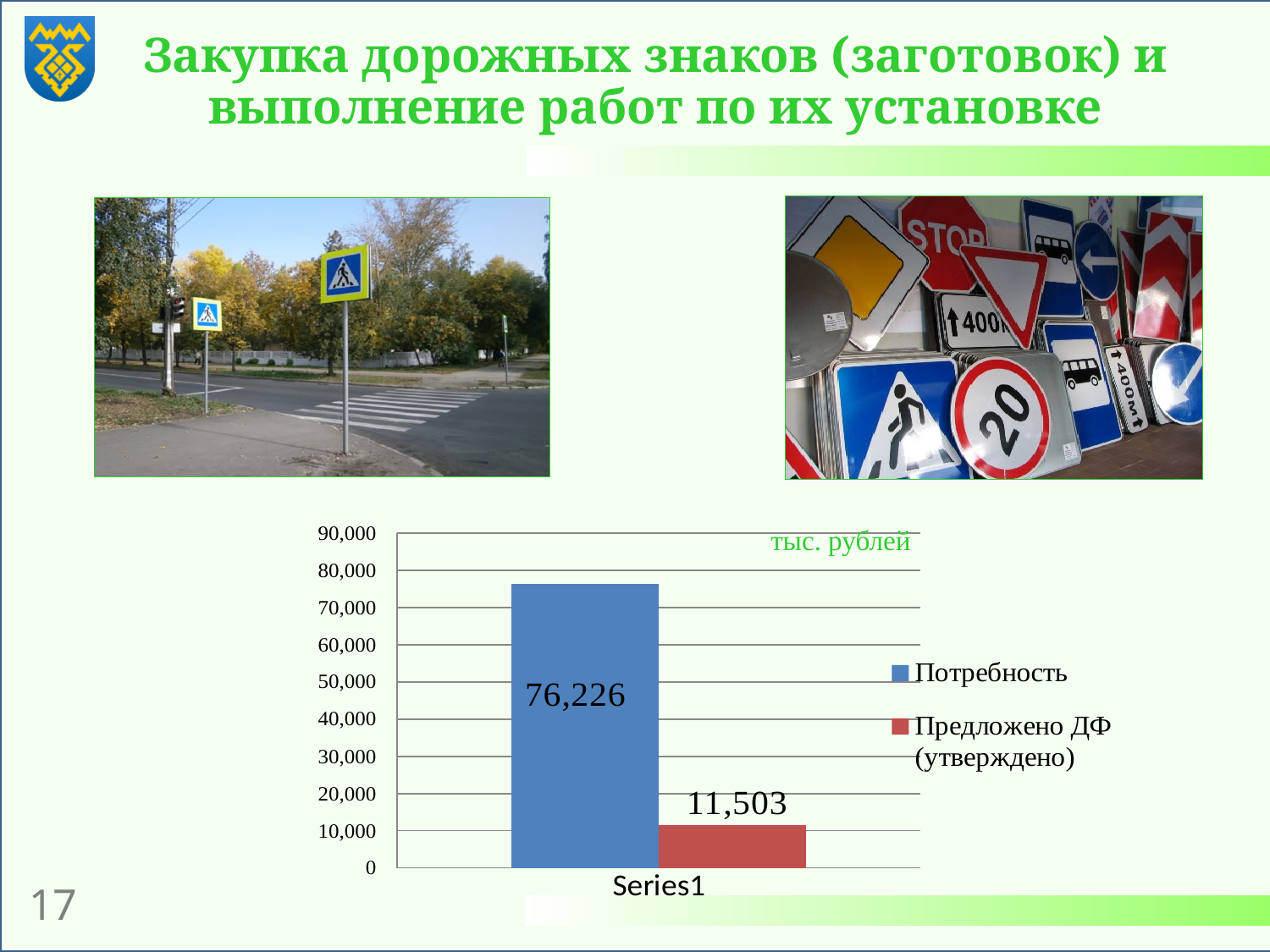
What kind of chart is shown on the slide? bar chart Is the value of the Предложено ДФ (утверждено) bar greater or less than 20,000? less What is the highest value shown on the chart's y axis? 90,000 What is the value of the Предложено ДФ (утверждено) bar on the chart? 11,503 Which series has the lowest value on the chart? Предложено ДФ (утверждено) Which series has the higher value on the chart, Потребность or Предложено ДФ (утверждено)? Потребность Is the value of the Потребность bar greater or less than 70,000? greater What is the category label shown on the x axis of the chart? Series1 What is the value of the Потребность bar on the chart? 76,226 What unit is indicated on the chart? тыс. рублей What is the difference between the Потребность value and the Предложено ДФ (утверждено) value on the chart? 64,723 How many series does the chart legend list? 2